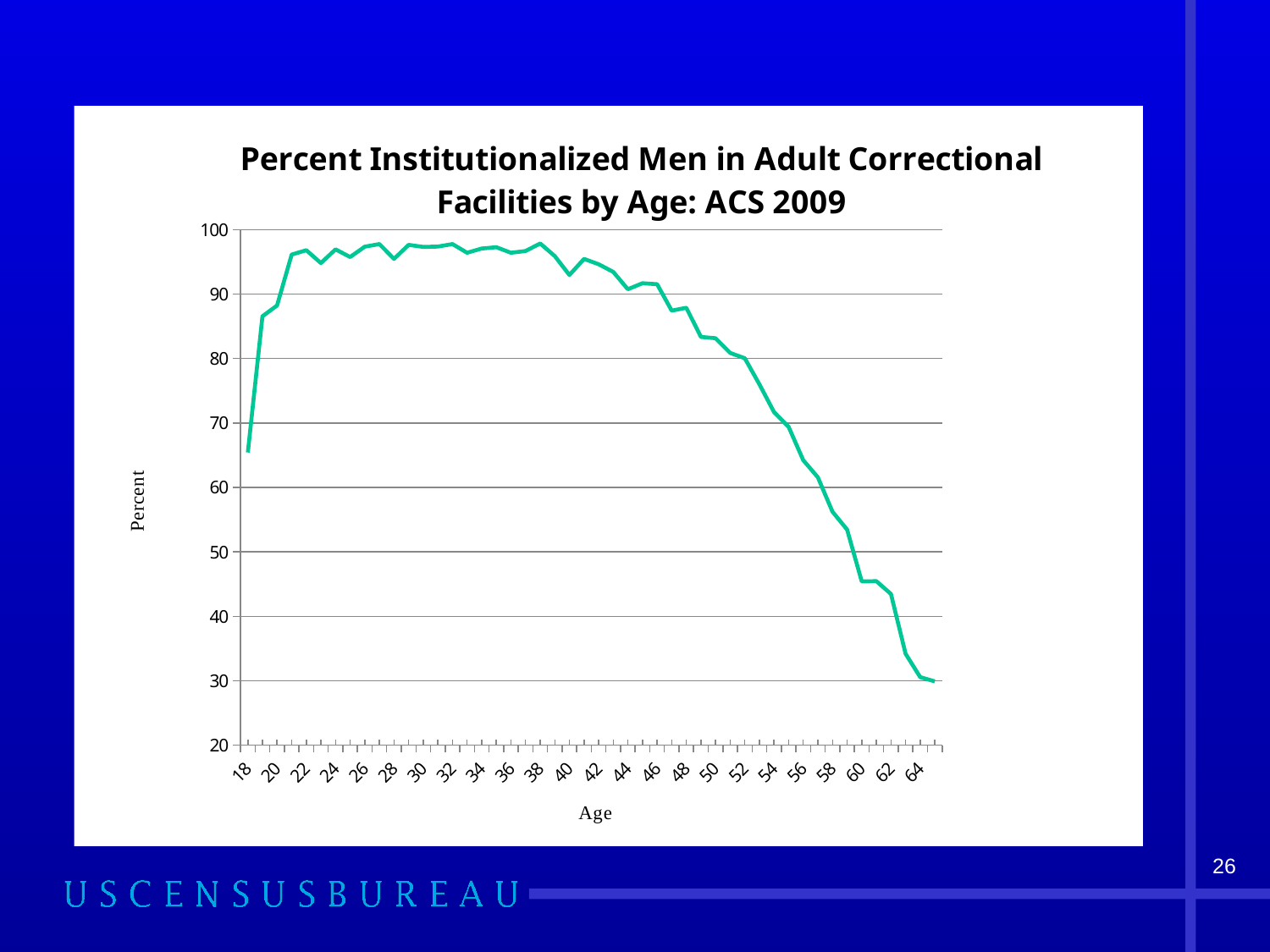
What kind of chart is shown on the slide? line chart Which is larger, the value for age 18 or the value for age 64? age 18 How many data series are plotted on the chart? 1 What is the label on the x axis of the chart? Age Is the value for age 30 greater or less than 90? greater Do the values rise or fall along the x axis from age 40 to age 64? fall Is the value for age 64 greater or less than 40? less Is the value for age 50 greater or less than 80? greater What is the title of the chart? Percent Institutionalized Men in Adult Correctional Facilities by Age: ACS 2009